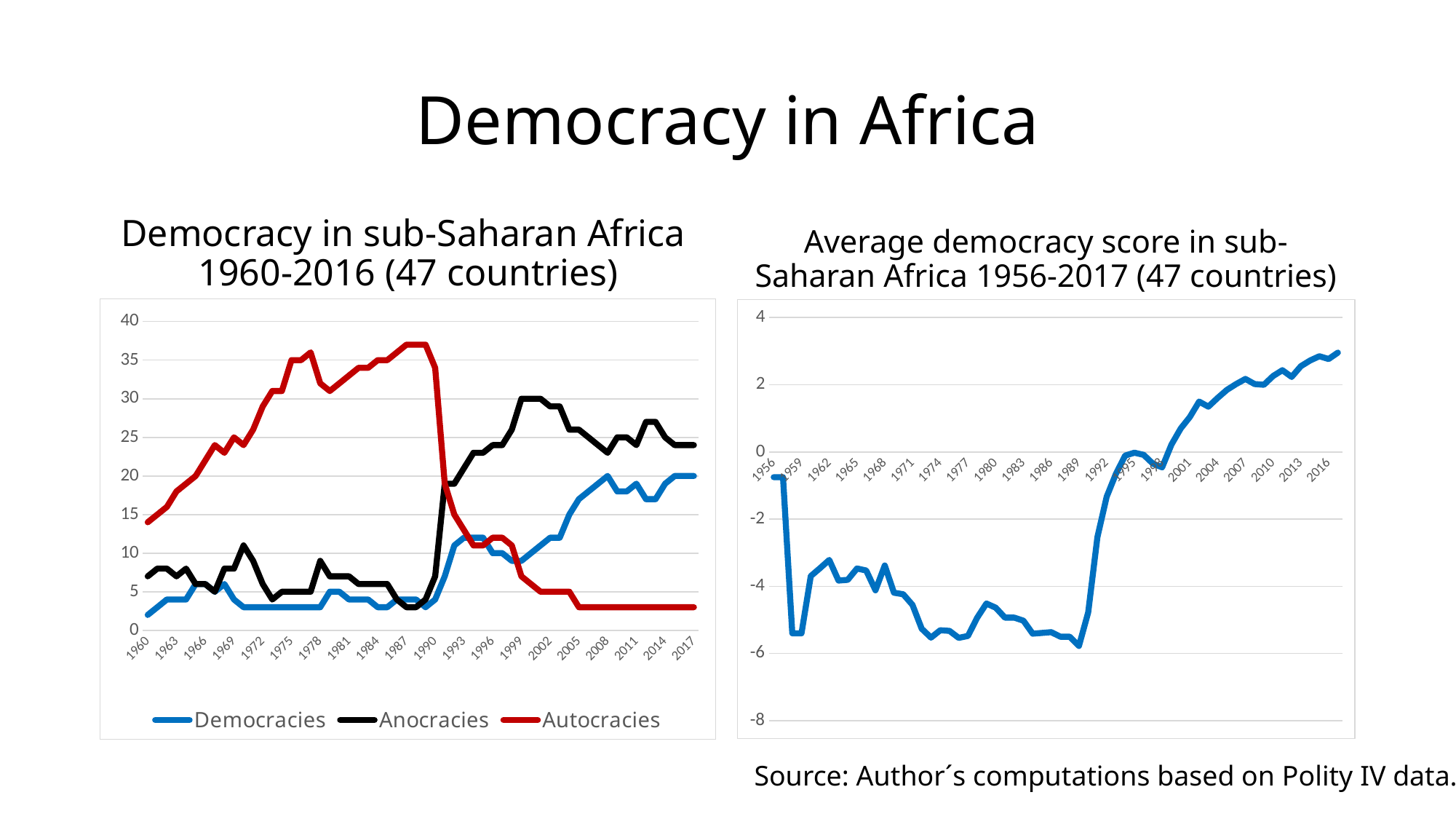
In the right chart, does the average democracy score rise or fall between 1992 and 2016? rise In the left chart, which series has the higher value in 2017, Democracies or Autocracies? Democracies In the left chart, is the value for Autocracies in 1987 greater or less than 30? greater In the left chart, what is the value for Democracies in 2017? 20 In the right chart, is the average democracy score in 1989 greater or less than -4? less What are the three series named in the legend of the left chart? Democracies, Anocracies, Autocracies What kind of chart is the right chart, 'Average democracy score in sub-Saharan Africa 1956-2017 (47 countries)'? line chart What kind of chart is the left chart, 'Democracy in sub-Saharan Africa 1960-2016 (47 countries)'? line chart In the left chart, which series has the highest value in 1980? Autocracies In the left chart, is the value for Autocracies in 2017 greater or less than 5? less How many series does the legend of the left chart list? 3